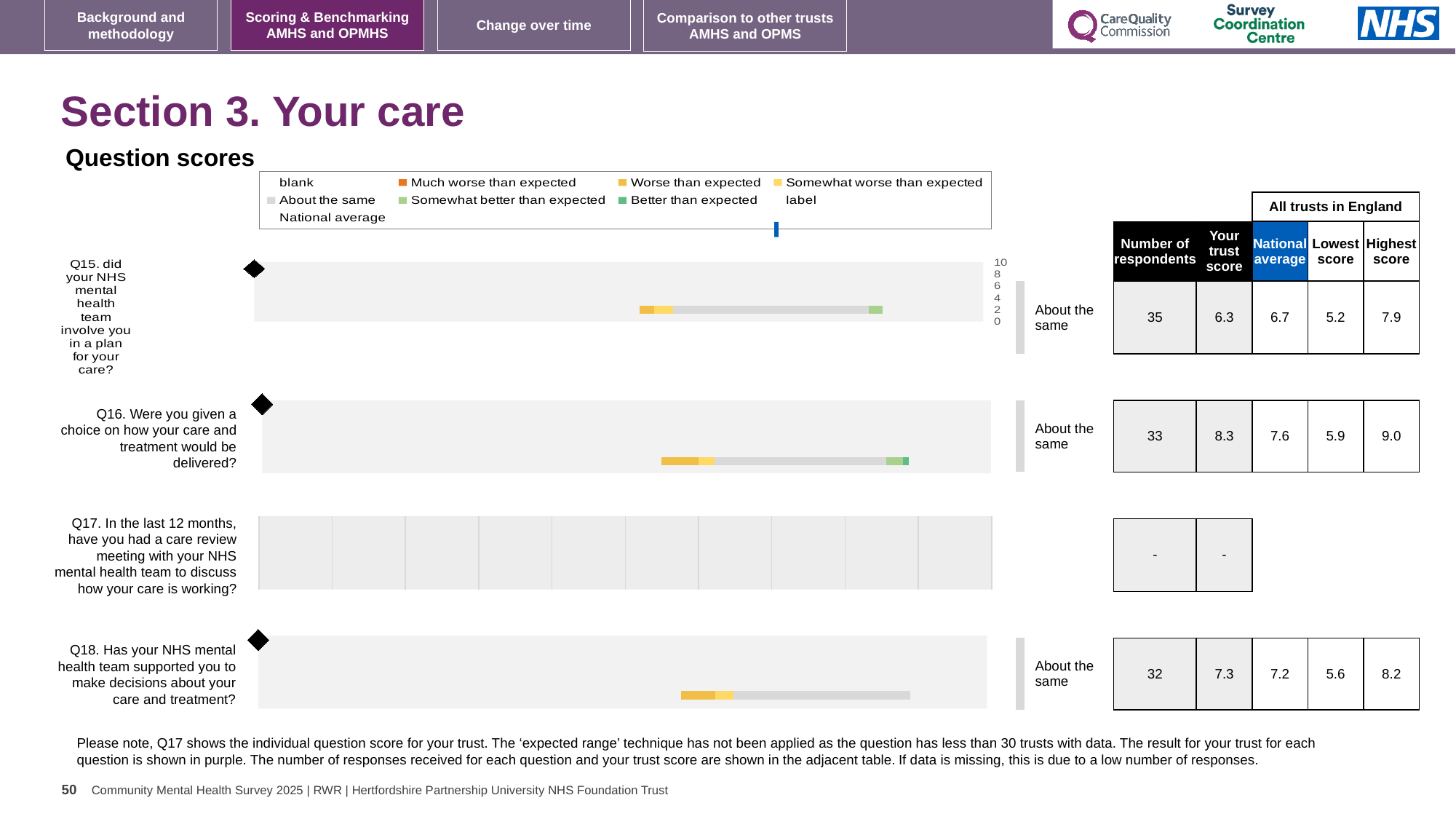
Is the trust score for Q15 higher or lower than the national average for Q15? lower What is the difference between the trust score and the national average for Q16? 0.7 What is the trust score for Q16 (Were you given a choice on how your care and treatment would be delivered)? 8.3 What kind of chart is used to show the question scores? bar chart What is the national average for Q15 (did your NHS mental health team involve you in a plan for your care)? 6.7 What benchmark category is shown next to Q18's bar? About the same How many questions are plotted in the Question scores chart? 4 Which question has the lowest trust score: Q15, Q16 or Q18? Q15 What is the highest score among all trusts in England for Q16? 9.0 How many respondents answered Q18 (Has your NHS mental health team supported you to make decisions about your care and treatment)? 32 What is the lowest score among all trusts in England for Q18? 5.6 Which question has the highest trust score: Q15, Q16 or Q18? Q16